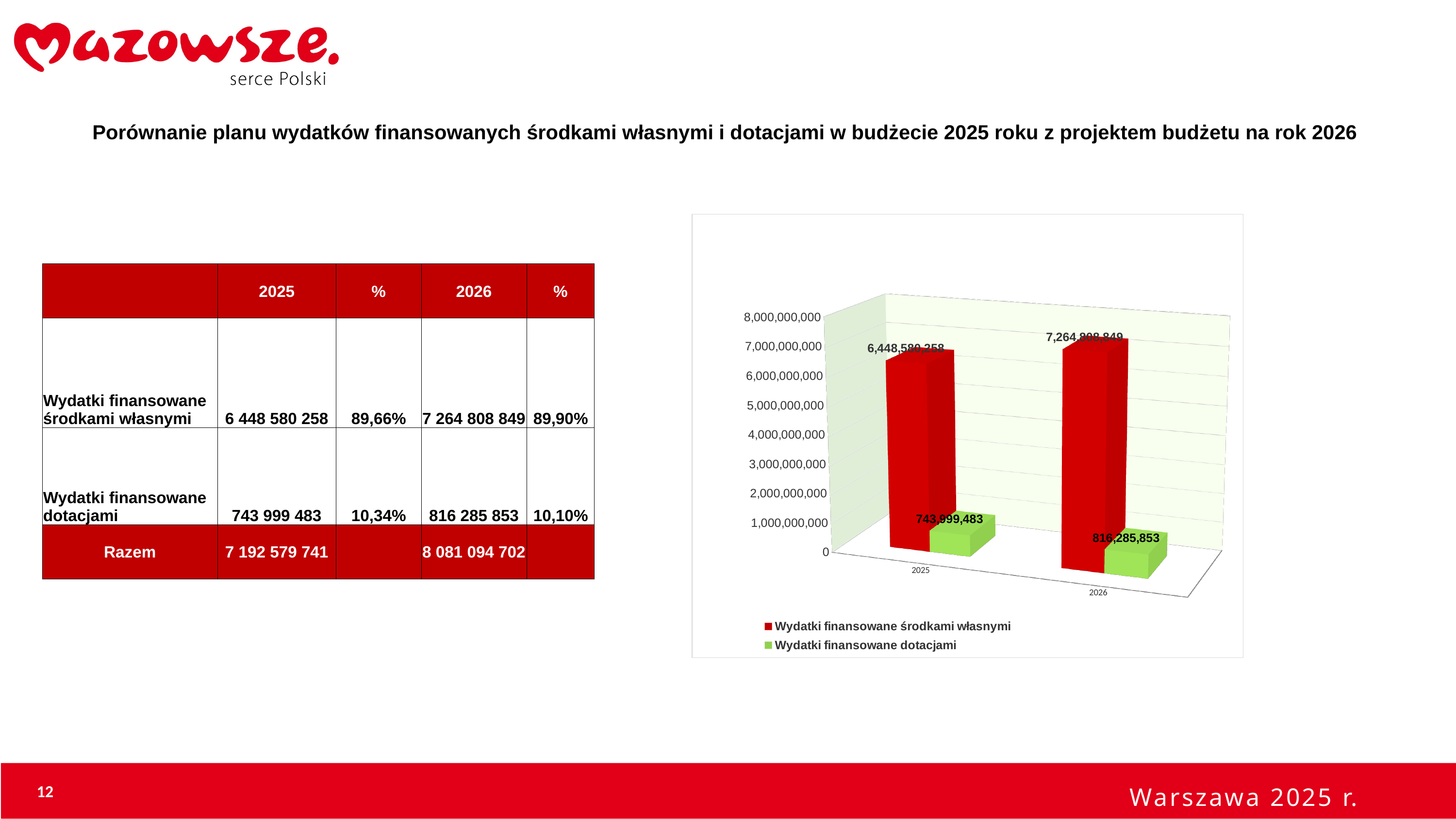
Which colour represents Wydatki finansowane dotacjami in the chart? green What is the value for Wydatki finansowane środkami własnymi in 2025? 6,448,580,258 What kind of chart is shown on the slide? bar chart Which year has the higher value for Wydatki finansowane środkami własnymi? 2026 How many series does the legend list? 2 By how much does Wydatki finansowane dotacjami in 2026 exceed the 2025 value? 72,286,370 Is the value for Wydatki finansowane dotacjami in 2026 greater or less than 1,000,000,000? less What is the value for Wydatki finansowane środkami własnymi in 2026? 7,264,808,849 Which year has the lower value for Wydatki finansowane dotacjami? 2025 What is the value for Wydatki finansowane dotacjami in 2025? 743,999,483 What is the difference between Wydatki finansowane środkami własnymi in 2026 and in 2025? 816,228,591 What is the value for Wydatki finansowane dotacjami in 2026? 816,285,853